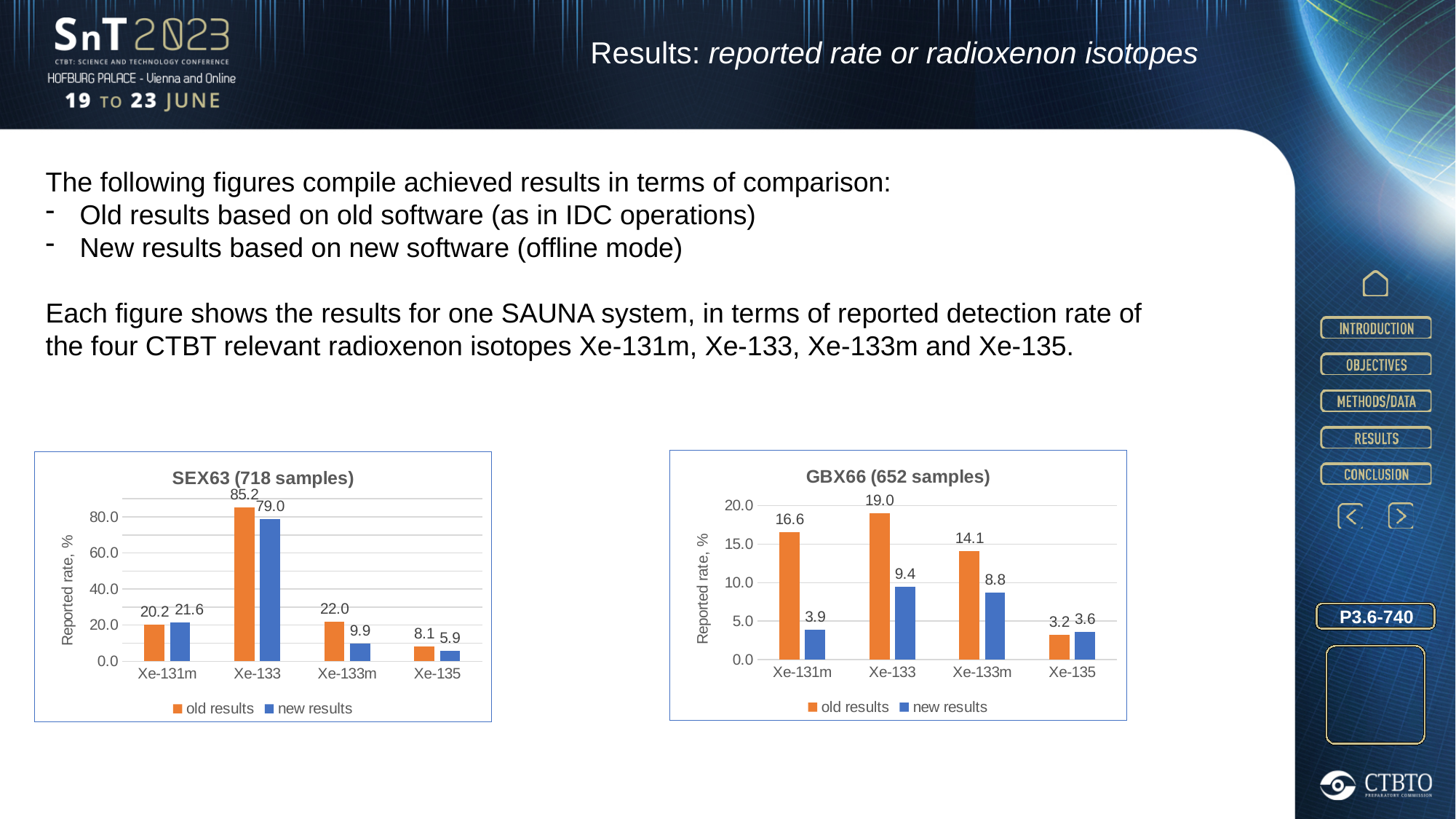
In the SEX63 (718 samples) chart, which isotope has the highest old results value? Xe-133 How many series does the legend of the SEX63 (718 samples) chart list? 2 In the GBX66 (652 samples) chart, which isotope has the lowest new results value? Xe-135 What type of chart is the GBX66 (652 samples) chart? bar chart In the GBX66 (652 samples) chart, what is the old results value for Xe-133m? 14.1 In the SEX63 (718 samples) chart, what is the new results value for Xe-133m? 9.9 In the GBX66 (652 samples) chart, what is the difference between the old and new results for Xe-131m? 12.7 In the SEX63 (718 samples) chart, which is larger for Xe-131m: old results or new results? new results In the SEX63 (718 samples) chart, what is the old results value for Xe-133? 85.2 How many isotope categories are shown in the GBX66 (652 samples) chart? 4 In the SEX63 (718 samples) chart, what is the difference between the old and new results for Xe-133m? 12.1 In the GBX66 (652 samples) chart, what is the new results value for Xe-131m? 3.9